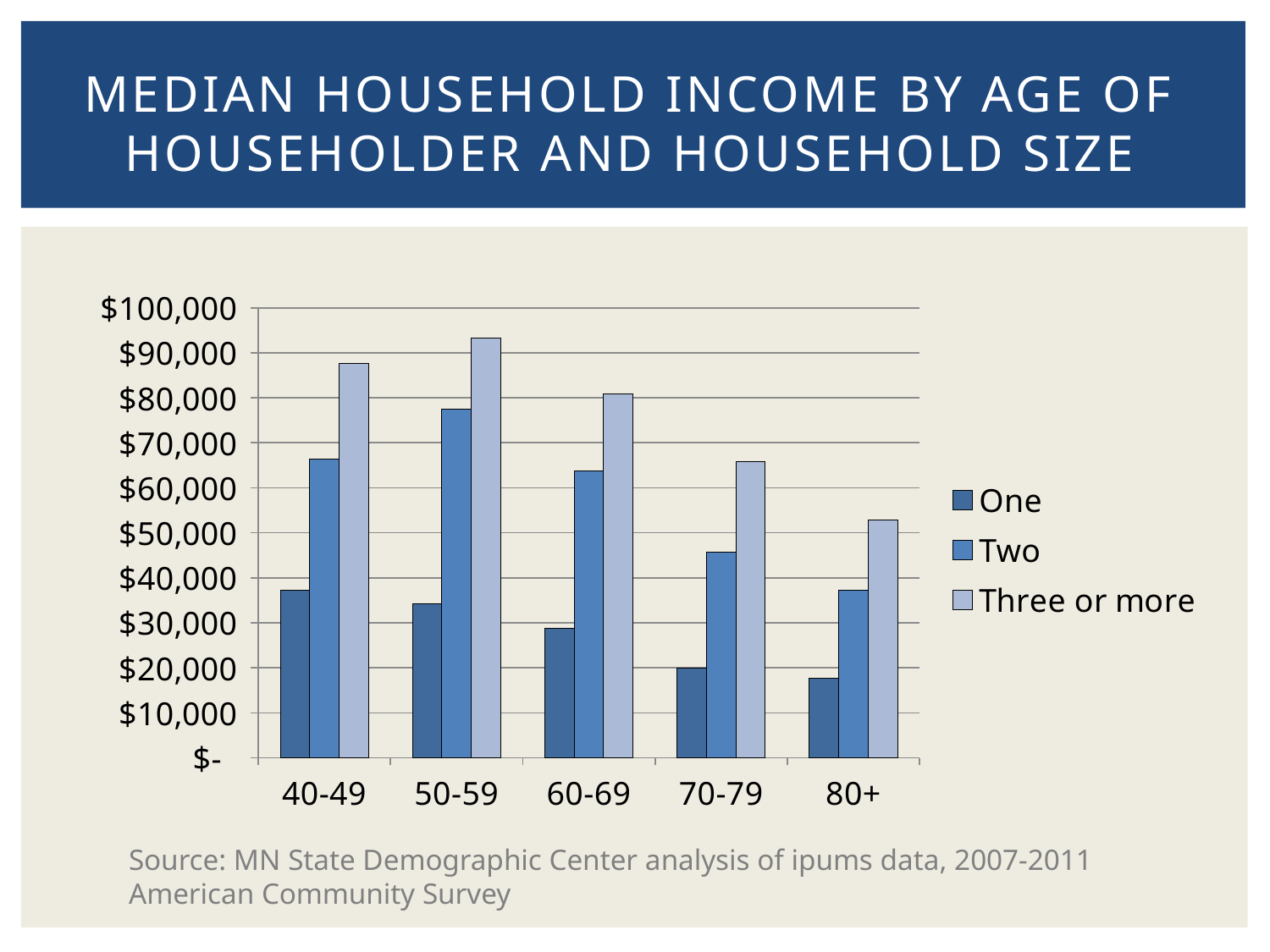
What kind of chart is shown on the slide? bar chart Is the value for Three or more in the 70-79 age group greater or less than $60,000? greater Is the value for Two in the 50-59 age group greater or less than $70,000? greater Is the value for Two in the 70-79 age group greater or less than $50,000? less Do the values for the One series rise or fall as the age of householder increases? fall How many age groups are shown on the x axis? 5 Which age group and household size has the lowest median household income? One, 80+ Which age group and household size has the highest median household income? Three or more, 50-59 What is the title of the chart? Median Household Income by Age of Householder and Household Size How many series does the legend list? 3 Which is larger: the value for Two in the 50-59 age group or the value for Three or more in the 70-79 age group? Two in the 50-59 age group